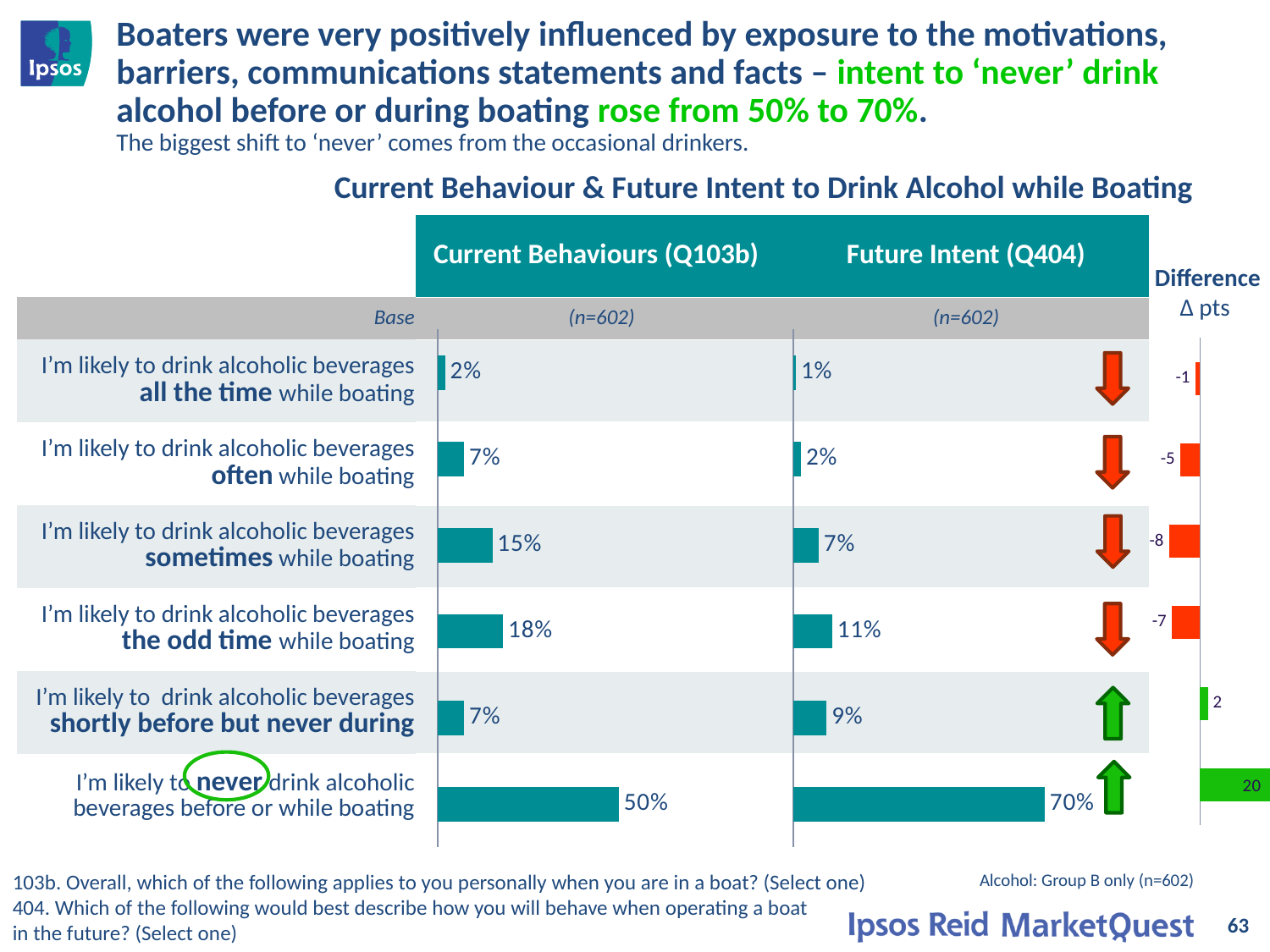
In the Difference (Δ pts) chart, which category has the largest negative difference? I'm likely to drink alcoholic beverages sometimes while boating Which is larger: the Current Behaviours (Q103b) value for drinking often while boating or the Future Intent (Q404) value for drinking often while boating? Current Behaviours (Q103b) In the Current Behaviours (Q103b) chart, what percentage of boaters say they are likely to never drink alcoholic beverages before or while boating? 50% What is the difference between the Future Intent (Q404) and Current Behaviours (Q103b) values for drinking alcoholic beverages the odd time while boating? -7 In the Difference (Δ pts) chart, what is the difference shown for drinking alcoholic beverages shortly before but never during boating? 2 In the Future Intent (Q404) chart, what percentage of boaters say they are likely to never drink alcoholic beverages before or while boating? 70% In the Future Intent (Q404) chart, what is the value for drinking alcoholic beverages sometimes while boating? 7% What kind of chart is used for the Current Behaviours (Q103b) data? Bar chart In the Current Behaviours (Q103b) chart, which category has the lowest value? I'm likely to drink alcoholic beverages all the time while boating How many categories are shown in the Current Behaviours (Q103b) chart? 6 In the Future Intent (Q404) chart, which category has the highest value? I'm likely to never drink alcoholic beverages before or while boating In the Current Behaviours (Q103b) chart, what is the value for drinking alcoholic beverages the odd time while boating? 18%